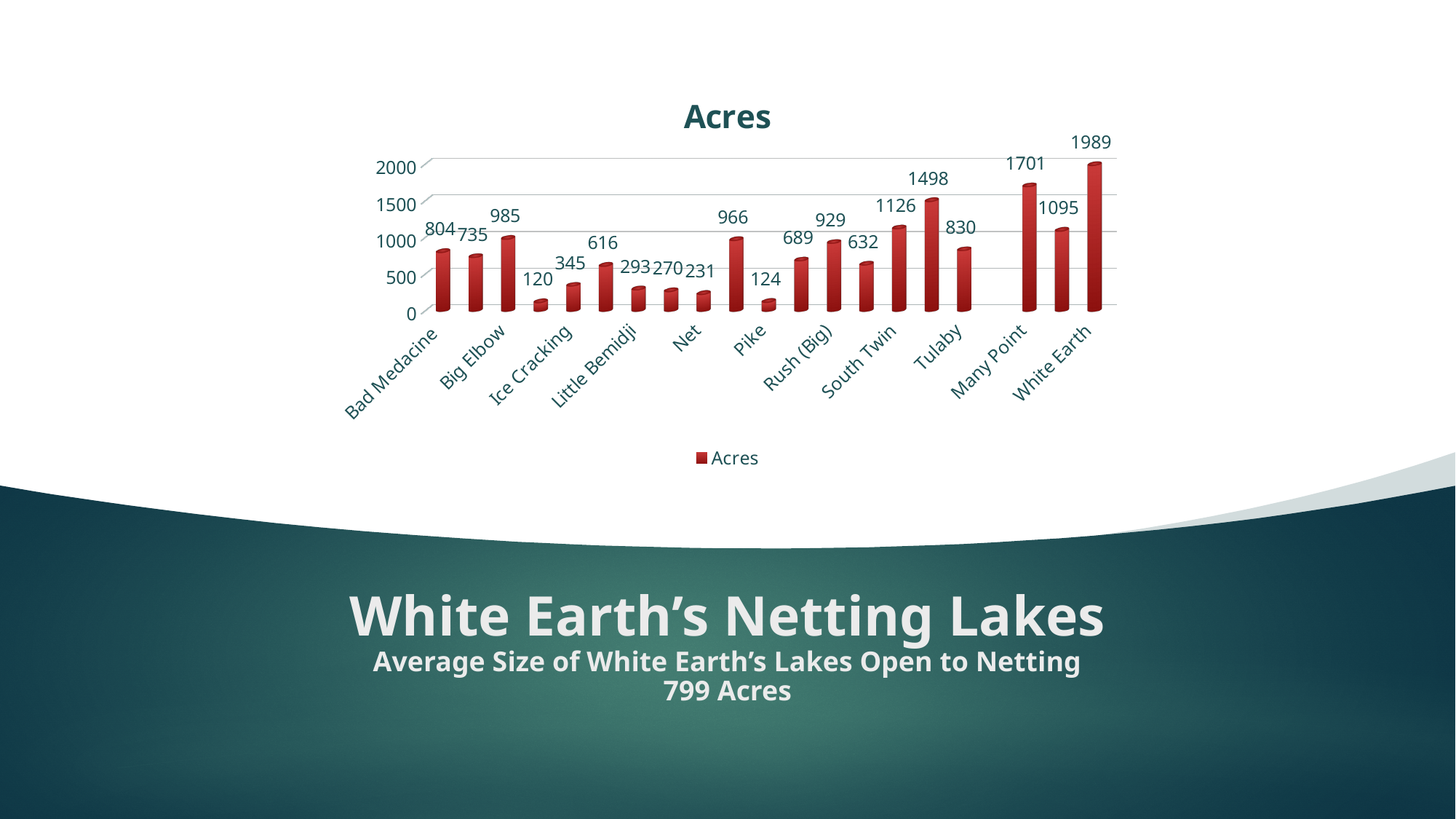
What is the value for White Earth? 1989 What is the difference between the values for White Earth and Many Point? 288 What is the title of the chart? Acres How many series does the legend list? 1 What kind of chart is shown? bar chart What is the value for Many Point? 1701 Is the value for Rush (Big) greater or less than 500? greater What is the value for Pike? 124 What is the value for South Twin? 1126 Which labeled lake has the highest value? White Earth Which is larger, the value for Big Elbow or the value for Bad Medacine? Big Elbow What is the value for Bad Medacine? 804